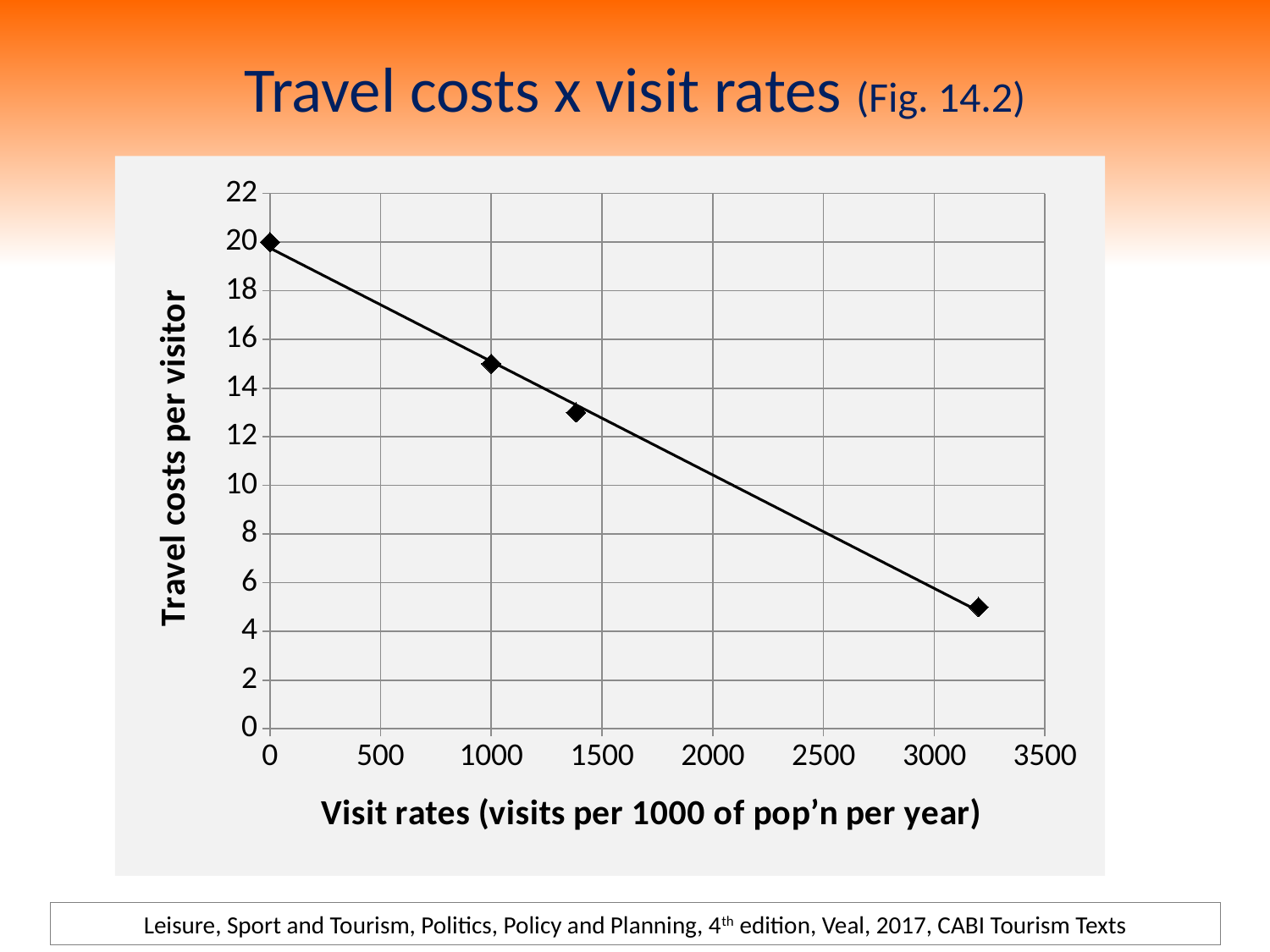
What is the travel cost per visitor at a visit rate of 0? 20 How many data points are plotted on the chart? 4 What is the title of the x axis? Visit rates (visits per 1000 of pop’n per year) Is the travel cost per visitor at a visit rate of 1000 greater or less than 14? greater What is the title of the y axis? Travel costs per visitor Which data point has the highest travel cost per visitor: the one at visit rate 0 or the one at visit rate 1000? the one at visit rate 0 At which visit rate is the travel cost per visitor highest? 0 Is the travel cost per visitor for the rightmost data point greater or less than 6? less Is the travel cost per visitor at a visit rate of 1000 greater or less than 16? less Do travel costs per visitor rise or fall as visit rates increase along the x axis? fall What kind of chart is shown on the slide? scatter chart with a trend line